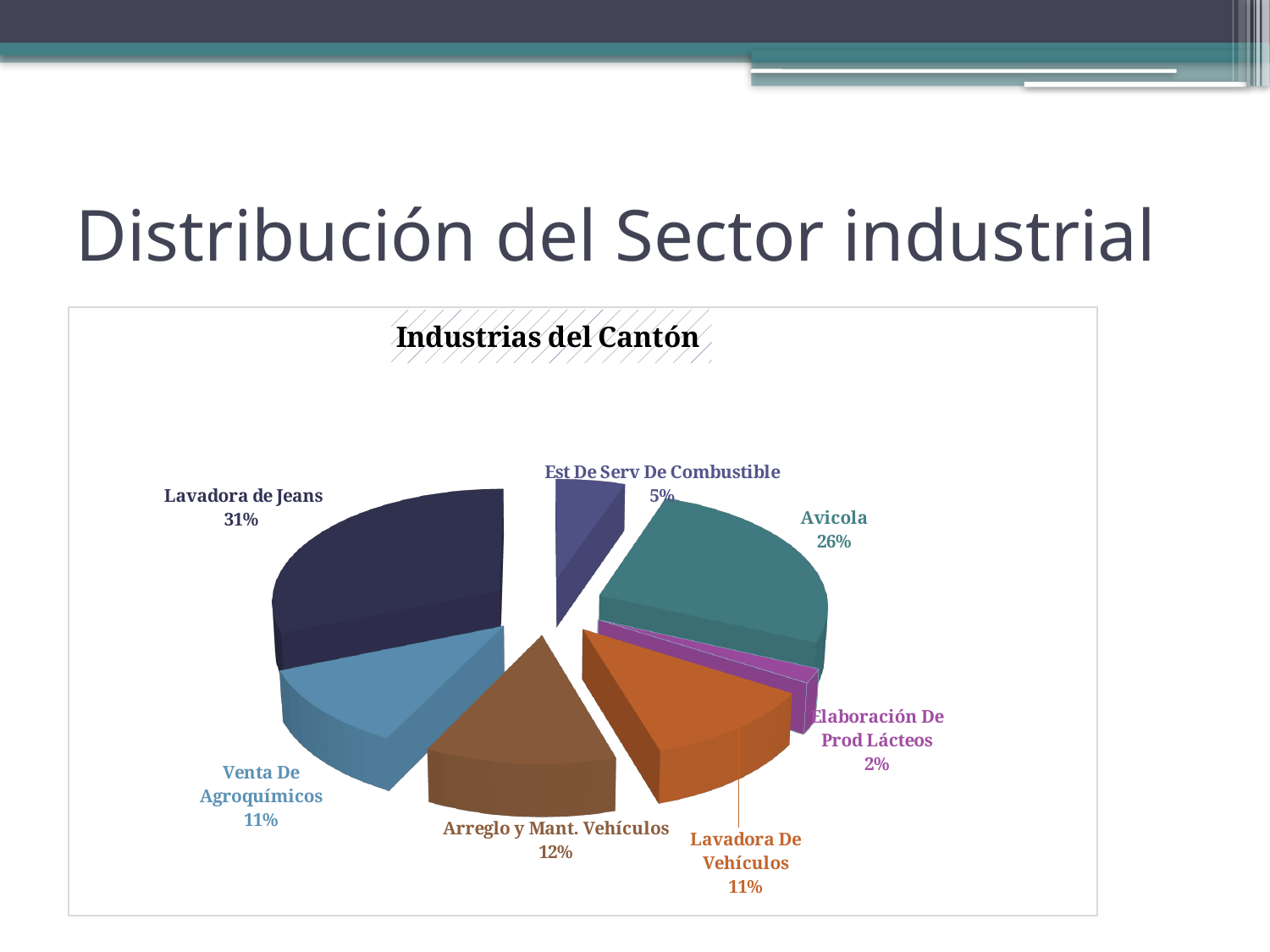
What is the difference in percentage points between Lavadora de Jeans and Avicola? 5 What kind of chart is shown on the slide? Pie chart What is the title of the chart? Industrias del Cantón What percentage is shown for Est De Serv De Combustible? 5% What percentage is shown for Elaboración De Prod Lácteos? 2% Which is larger, the share for Arreglo y Mant. Vehículos or the share for Est De Serv De Combustible? Arreglo y Mant. Vehículos What share of the pie does Lavadora de Jeans represent? 31% How many categories are shown in the pie chart? 7 What percentage is shown for Avicola? 26% Which category has the largest share of the pie? Lavadora de Jeans Which category has the smallest share of the pie? Elaboración De Prod Lácteos What percentage is shown for Arreglo y Mant. Vehículos? 12%